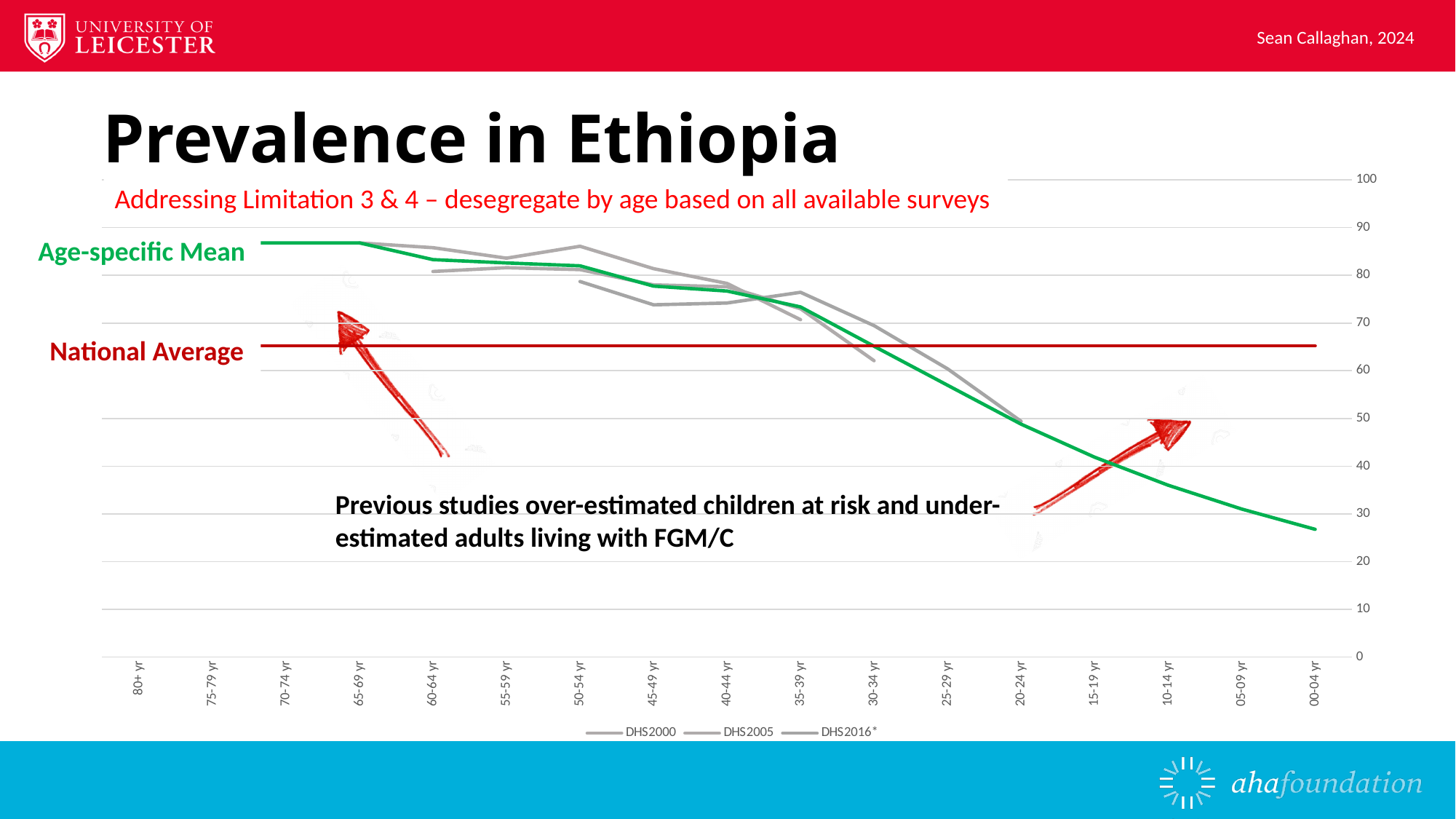
What kind of chart is shown on the slide? line chart Is the Age-specific Mean for 00-04 yr greater or less than 30? less Which series are listed in the chart's legend? DHS2000, DHS2005, DHS2016* How many age-group categories are shown on the x axis of the chart? 17 Is the National Average line greater or less than 60? greater For which age group is the Age-specific Mean lowest? 00-04 yr Does the Age-specific Mean line rise or fall as it moves from the older age groups on the left to the younger age groups on the right? fall Is the Age-specific Mean for 10-14 yr greater or less than 40? less Which is larger, the Age-specific Mean for 70-74 yr or for 00-04 yr? 70-74 yr How many series does the legend at the bottom of the chart list? 3 What colour is the Age-specific Mean line on the chart? green